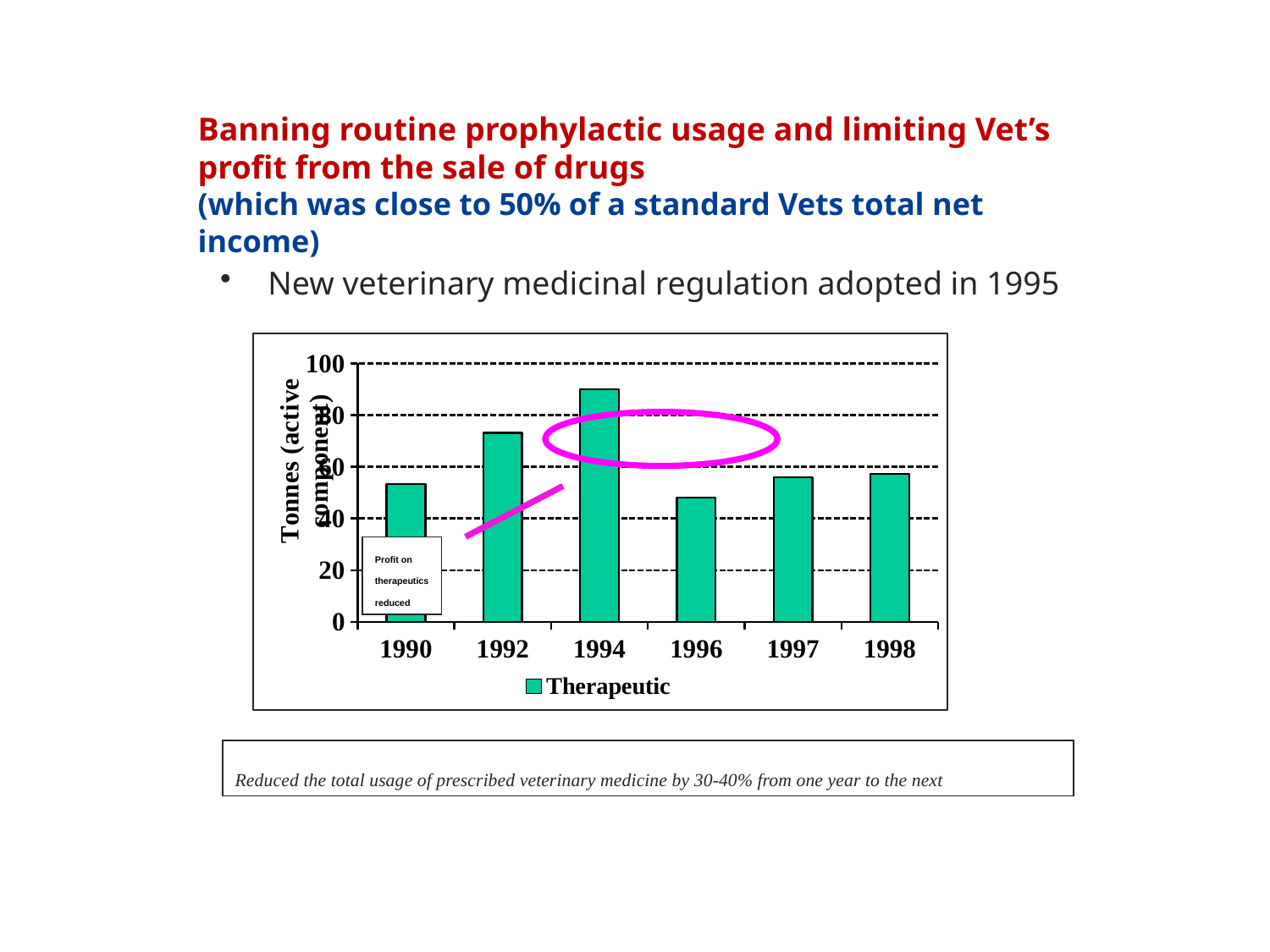
Is the Therapeutic value for 1992 greater or less than 60? greater What is the label on the y axis of the chart? Tonnes (active component) Is the Therapeutic value for 1990 greater or less than 40? greater How many series does the chart legend list? 1 Does the Therapeutic value rise or fall from 1994 to 1996? fall How many years are shown on the x axis of the chart? 6 Which year has the lowest Therapeutic value? 1996 Is the Therapeutic value for 1994 greater or less than 80? greater Which year has the larger Therapeutic value, 1994 or 1996? 1994 Which year has the highest Therapeutic value? 1994 What kind of chart is shown on the slide? bar chart